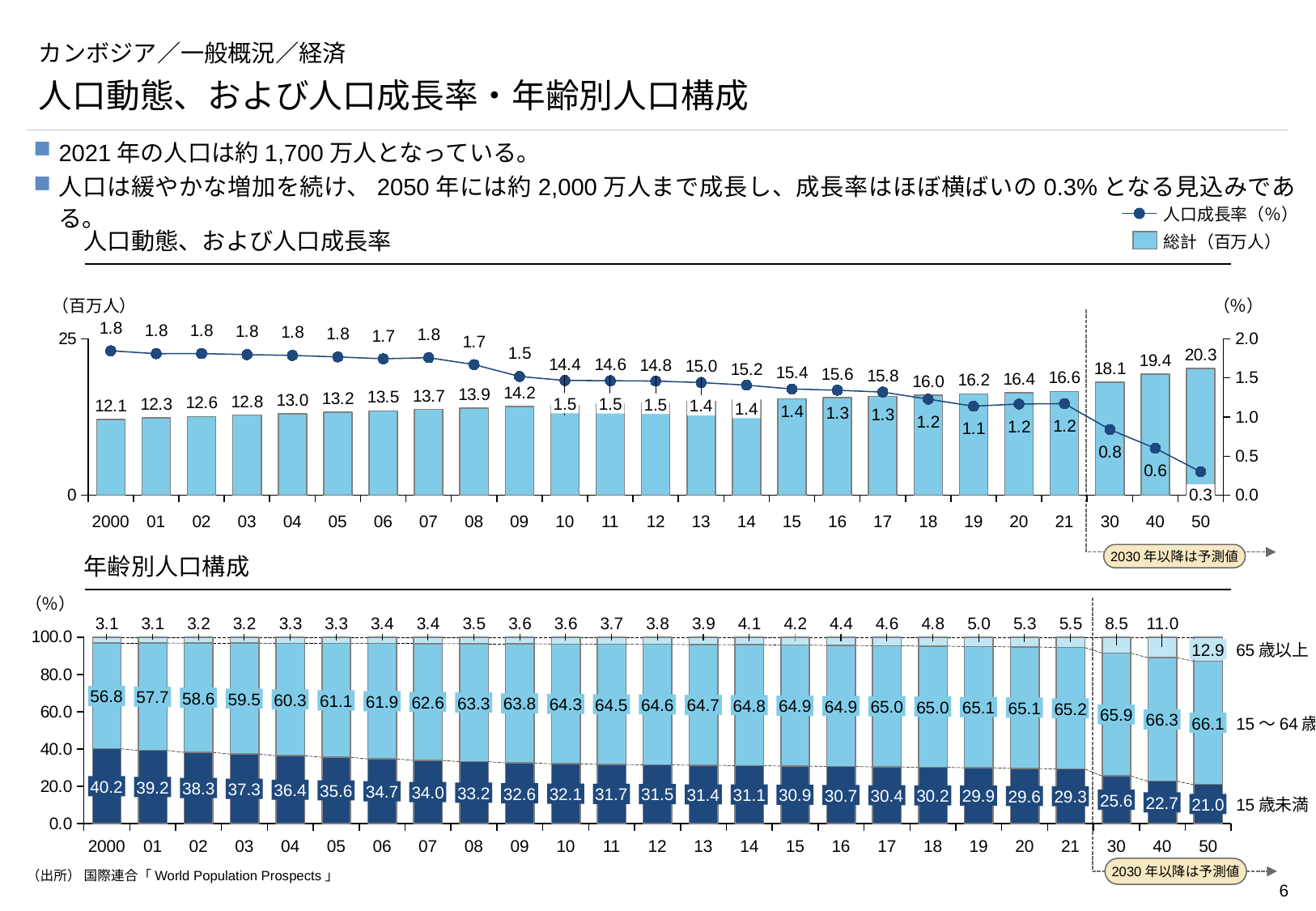
In the top chart (人口動態、および人口成長率), how many years are shown on the x axis? 25 In the top chart (人口動態、および人口成長率), does the population growth rate line rise or fall from 2000 to 2050? fall In the top chart (人口動態、および人口成長率), what is the population growth rate (人口成長率) for 2050? 0.3 In the bottom chart (年齢別人口構成), which year has the larger share of 15歳未満, 2000 or 2050? 2000 In the bottom chart (年齢別人口構成), what is the difference between the 15歳未満 share in 2000 and in 2021? 10.9 How many series does the legend of the top chart (人口動態、および人口成長率) list? 2 In the top chart (人口動態、および人口成長率), which year has the highest total population? 50 (2050) In the top chart (人口動態、および人口成長率), what is the total population (総計) for 2021? 16.6 In the top chart (人口動態、および人口成長率), which year has the lowest population growth rate? 50 (2050) What kind of chart is the bottom chart (年齢別人口構成)? stacked bar chart In the bottom chart (年齢別人口構成), what is the share of 65歳以上 in 2050? 12.9 In the top chart (人口動態、および人口成長率), what is the difference between the total population in 2050 and in 2000? 8.2